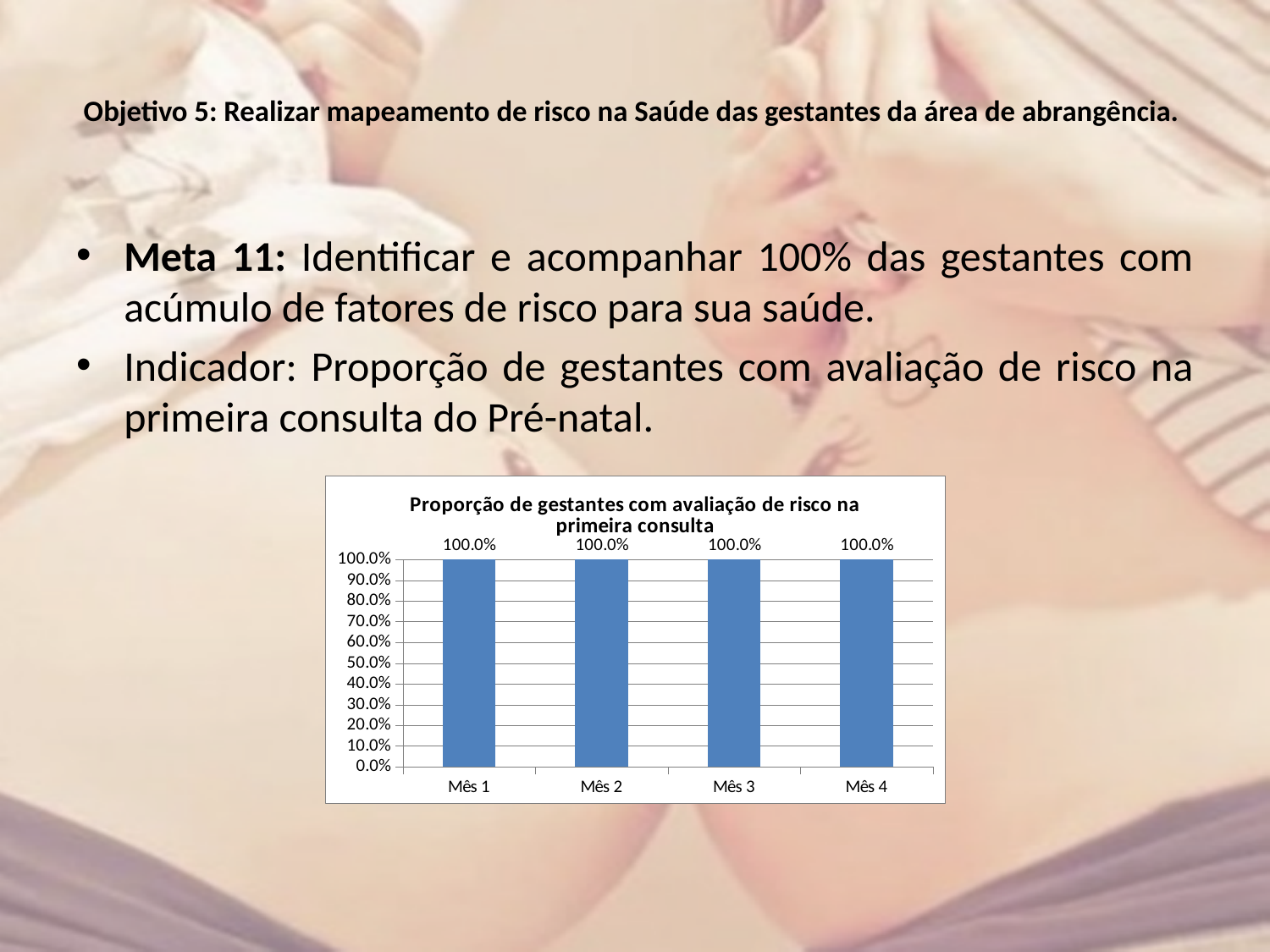
What is the value for Mês 1? 100.0% Is the value for Mês 2 greater or less than 50.0%? greater Do the values rise, fall or stay the same from Mês 1 to Mês 4? stay the same What is the value for Mês 4? 100.0% What is the highest value shown on the y axis? 100.0% What is the difference between the values for Mês 2 and Mês 4? 0.0% What is the title of the chart? Proporção de gestantes com avaliação de risco na primeira consulta What kind of chart is shown on the slide? bar chart How many categories are shown on the x axis? 4 What is the value for Mês 3? 100.0%